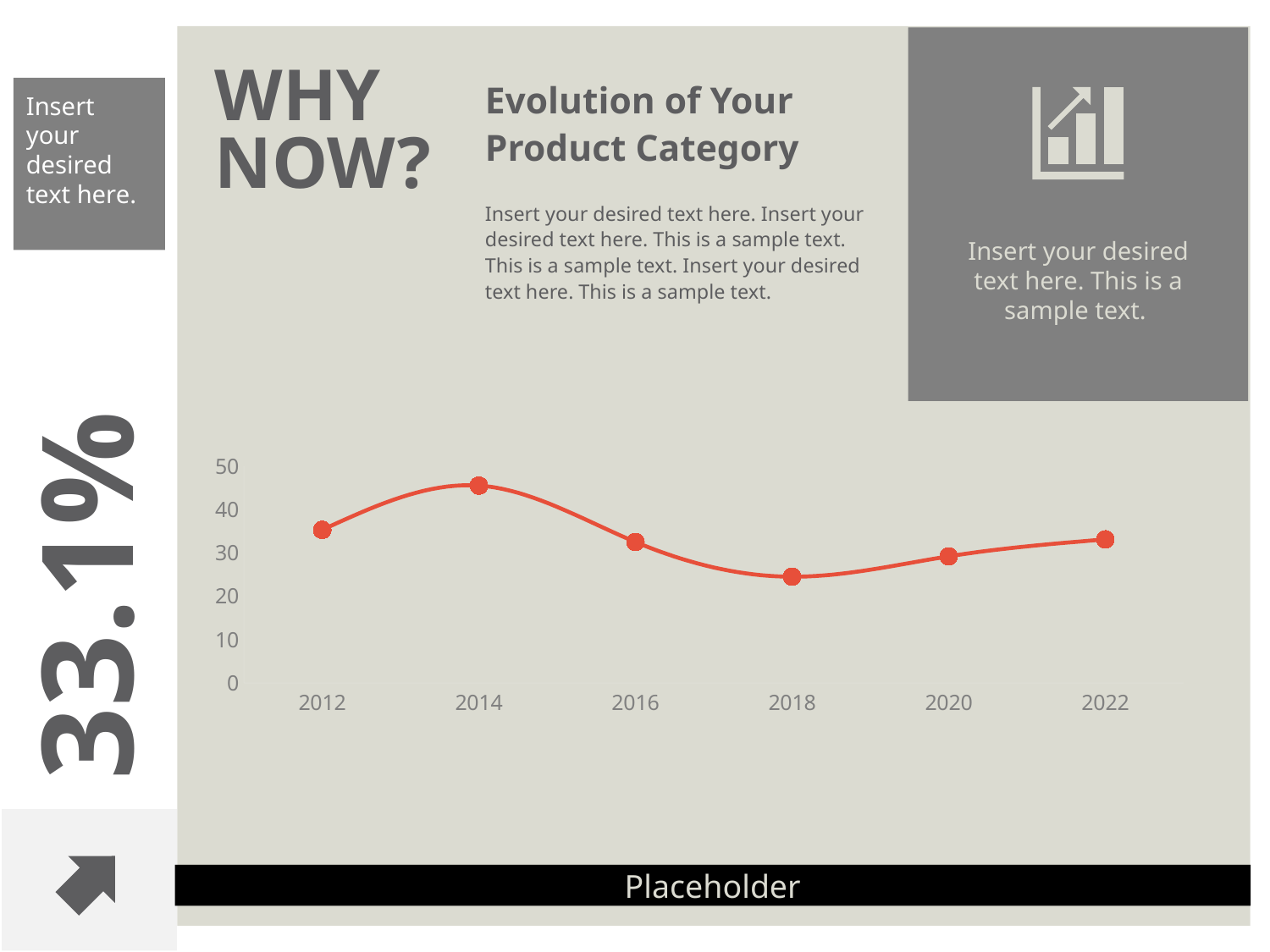
Which year has the lowest value on the line chart? 2018 Which is larger, the value for 2014 or the value for 2018? 2014 Do the values rise or fall from 2014 to 2018? fall Which year has the highest value on the line chart? 2014 Is the value for 2012 greater or less than 30? greater Is the value for 2014 greater or less than 40? greater What kind of chart is shown on the slide? line chart How many data points are plotted on the line chart? 6 Is the value for 2022 greater or less than 40? less What is the first year shown on the x axis of the chart? 2012 Which is larger, the value for 2022 or the value for 2018? 2022